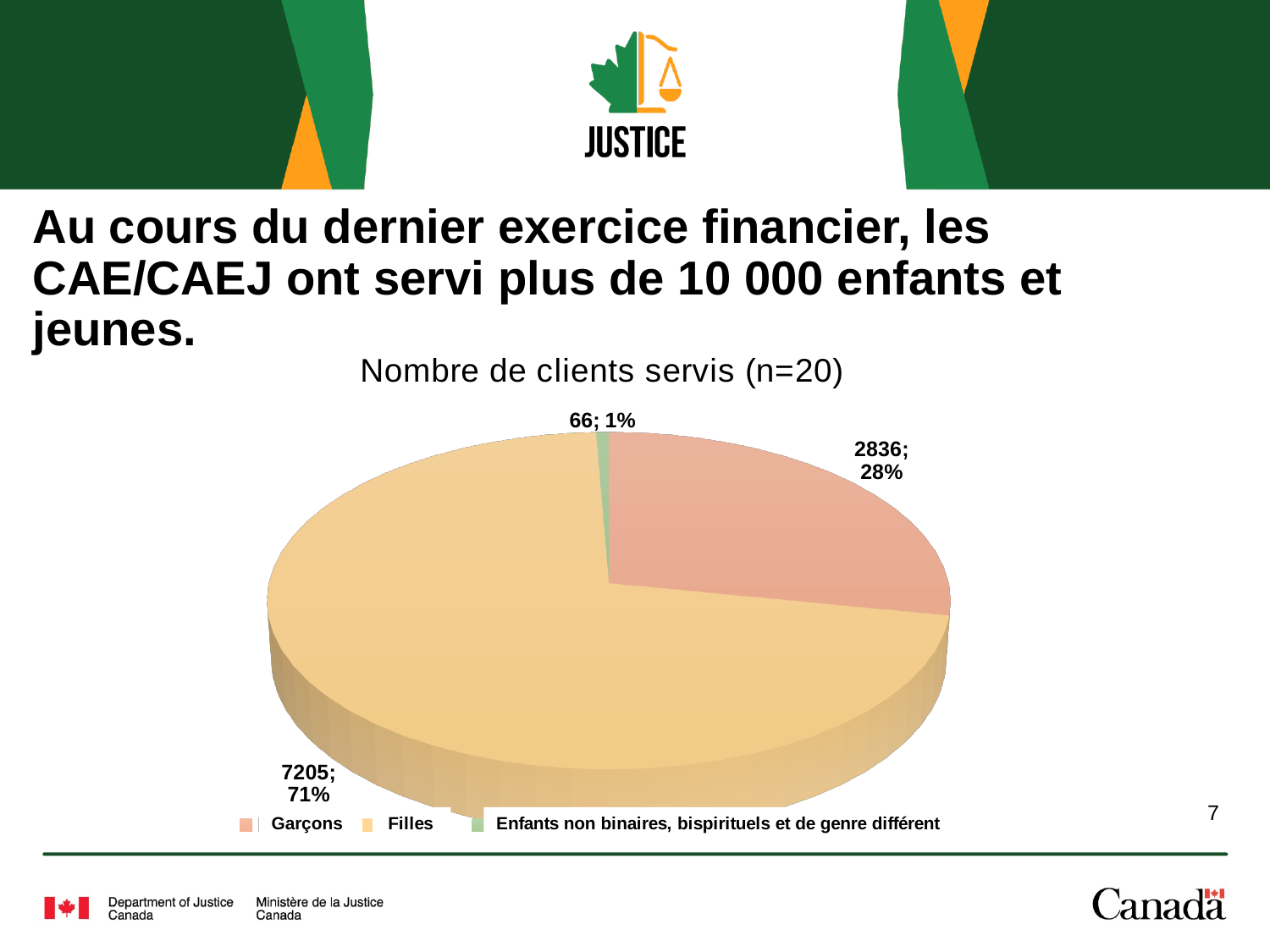
What is the difference between the number of Filles and the number of Garçons? 4369 Which is larger, the number of Garçons or the number of Enfants non binaires, bispirituels et de genre différent? Garçons How many clients served are Filles? 7205 Which category has the smallest slice of the pie? Enfants non binaires, bispirituels et de genre différent Which category has the largest slice of the pie? Filles How many categories does the legend list? 3 How many clients served are Enfants non binaires, bispirituels et de genre différent? 66 What share of the pie does Filles represent? 71% How many clients served are Garçons? 2836 What share of the pie does Garçons represent? 28% What kind of chart is shown on the slide? pie chart What is the title of the chart? Nombre de clients servis (n=20)